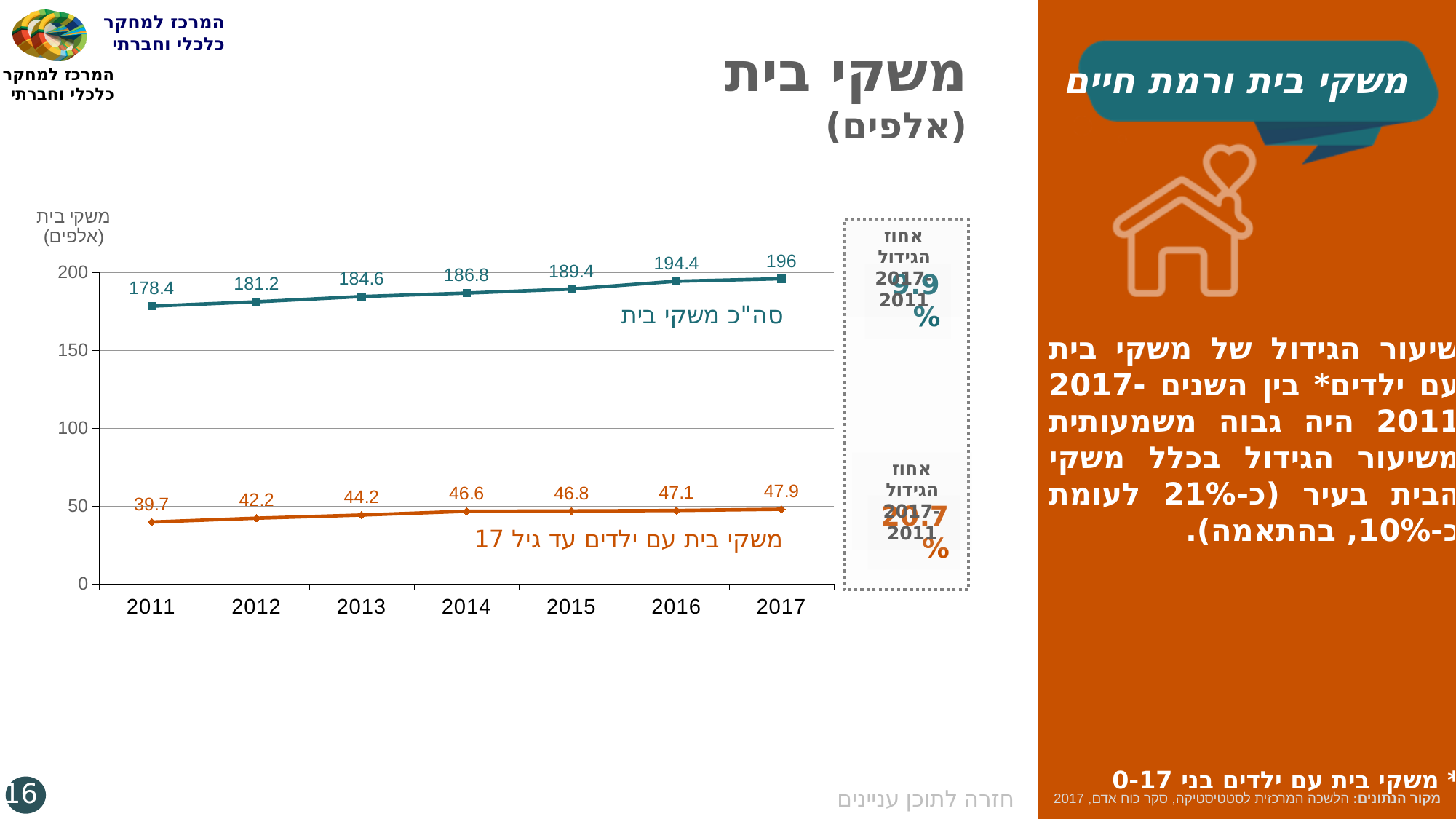
Do the values for total households (סה"כ משקי בית) rise or fall from 2011 to 2017? Rise What is the difference between total households in 2017 and in 2011? 17.6 What kind of chart is shown on the slide? Line chart In which year is the households with children up to age 17 series lowest? 2011 What is the value for households with children up to age 17 in 2014? 46.6 Which is larger: total households in 2015 or total households in 2013? 2015 What is the value for total households (סה"כ משקי בית) in 2016? 194.4 In which year is the total households (סה"כ משקי בית) series highest? 2017 What is the value for households with children up to age 17 (משקי בית עם ילדים עד גיל 17) in 2017? 47.9 What is the value for total households (סה"כ משקי בית) in 2011? 178.4 How many years are shown on the x axis of the chart? 7 What is the difference between households with children up to age 17 in 2012 and in 2011? 2.5